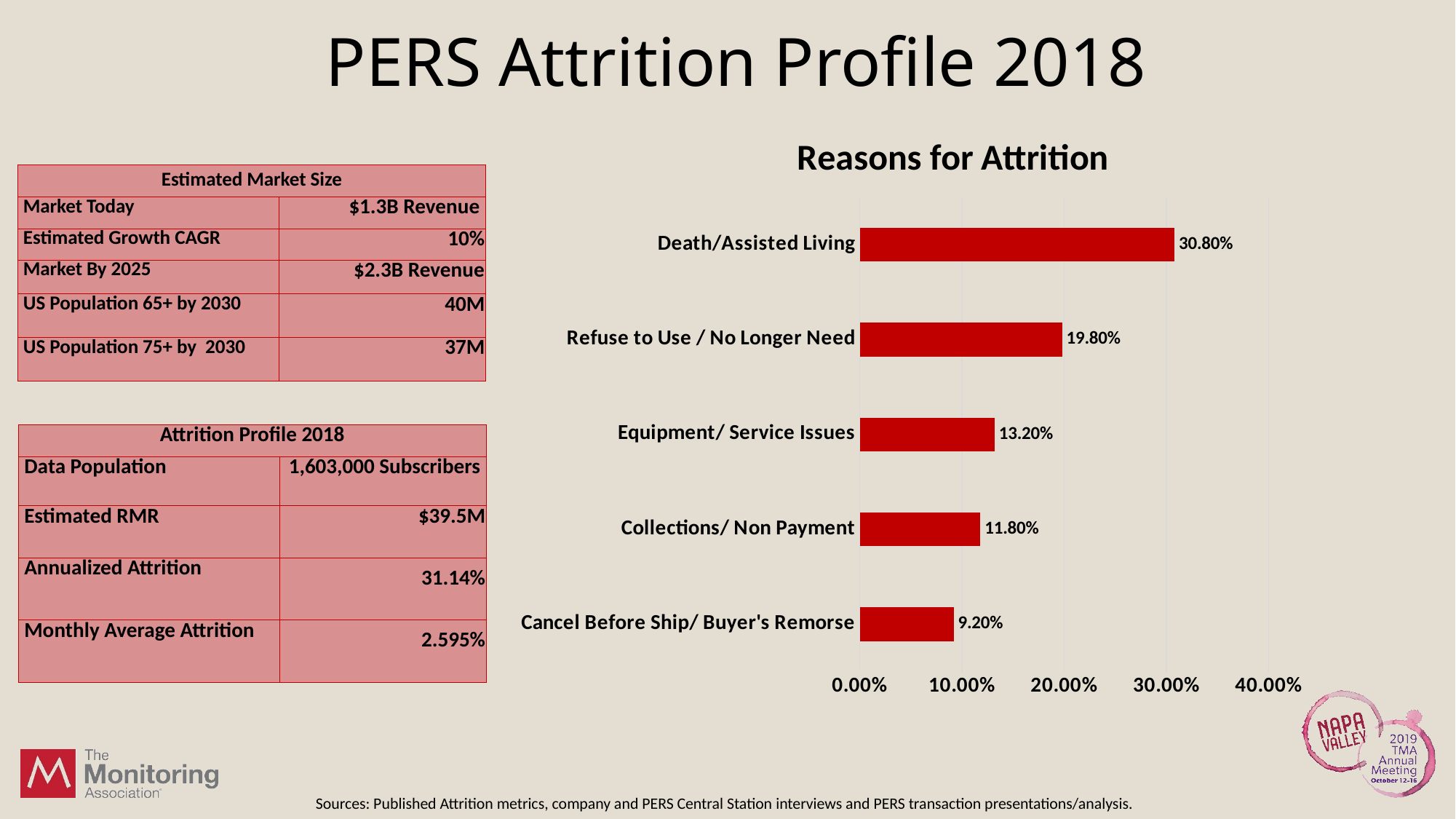
Which reason has the highest value in the Reasons for Attrition chart? Death/Assisted Living What kind of chart is the Reasons for Attrition chart? bar chart What is the title of the chart on the slide? Reasons for Attrition What is the value for Refuse to Use / No Longer Need in the Reasons for Attrition chart? 19.80% What is the value for Equipment/ Service Issues in the Reasons for Attrition chart? 13.20% How many reasons are shown in the Reasons for Attrition chart? 5 What is the value for Death/Assisted Living in the Reasons for Attrition chart? 30.80% What is the difference between Death/Assisted Living and Refuse to Use / No Longer Need in the Reasons for Attrition chart? 11.00% What is the value for Cancel Before Ship/ Buyer's Remorse in the Reasons for Attrition chart? 9.20% Which is larger in the Reasons for Attrition chart: Equipment/ Service Issues or Collections/ Non Payment? Equipment/ Service Issues Is the value for Collections/ Non Payment greater or less than 10.00% in the Reasons for Attrition chart? greater Which reason has the lowest value in the Reasons for Attrition chart? Cancel Before Ship/ Buyer's Remorse